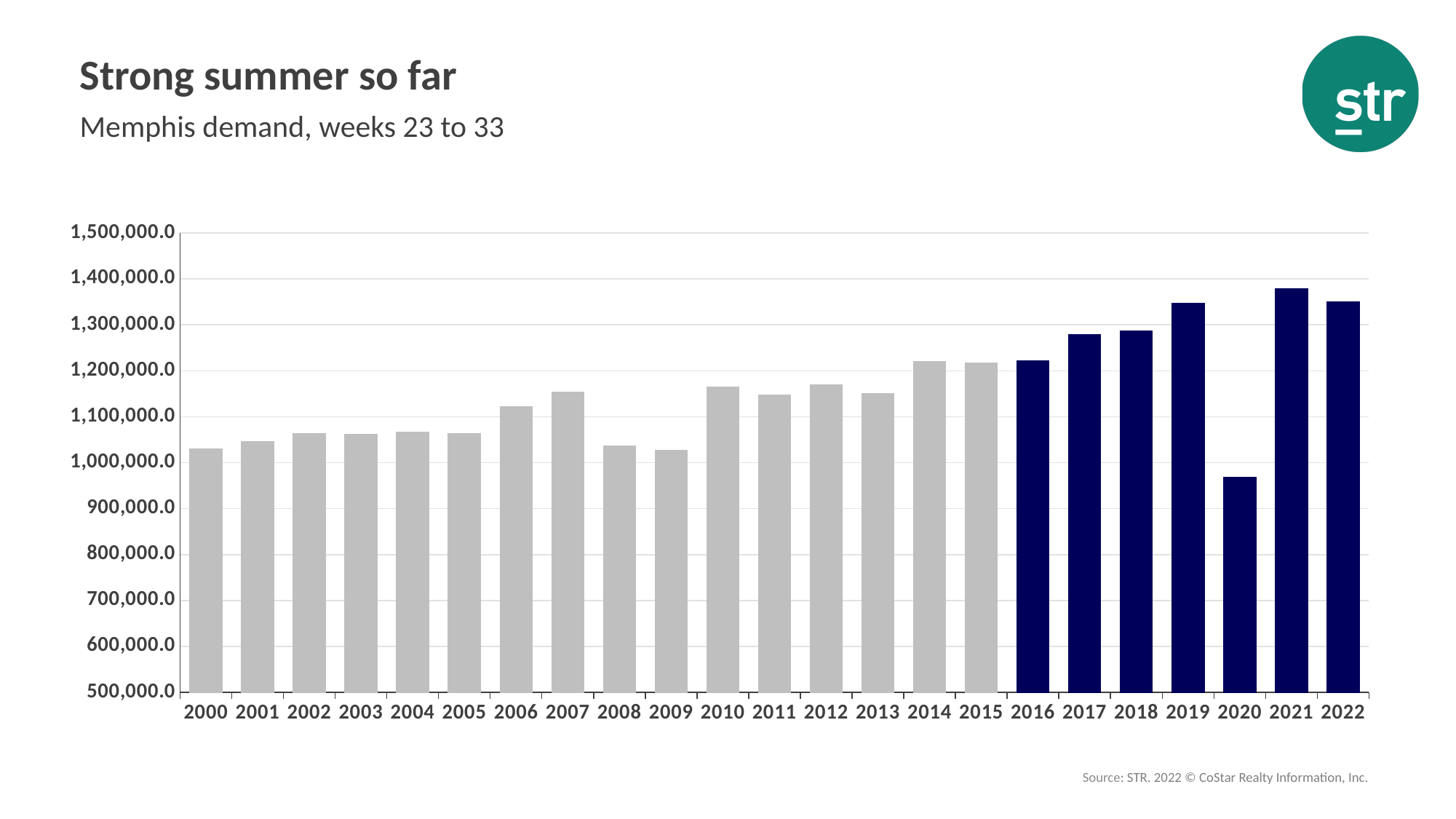
Which year has the highest Memphis demand in the chart? 2021 Is the value for 2020 greater or less than 1,000,000.0? less What kind of chart is shown on the slide? Bar chart Which year has the lowest Memphis demand in the chart? 2020 Is the value for 2021 greater or less than 1,300,000.0? greater Which year has the larger value, 2019 or 2017? 2019 Is the value for 2017 greater or less than 1,300,000.0? less How many years (bars) are plotted in the chart? 23 What is the subtitle of the chart? Memphis demand, weeks 23 to 33 Which year has the larger value, 2010 or 2008? 2010 Do the values rise or fall from 2016 to 2019? Rise